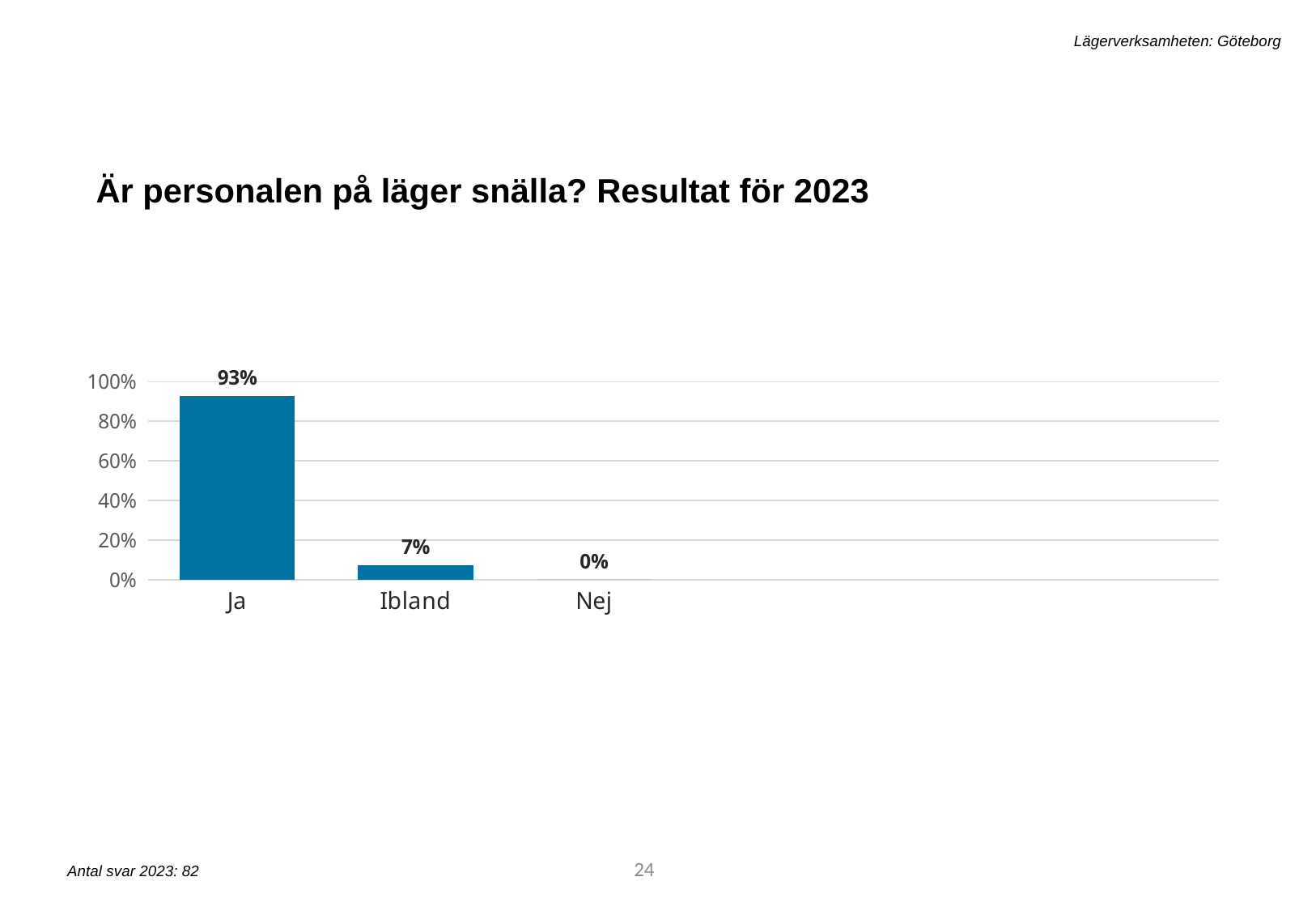
Is the value for Ja greater or less than 80%? greater Is the value for Ibland greater or less than 20%? less Which category has the lowest value? Nej Which is larger, the value for Ibland or the value for Nej? Ibland What is the title of the slide? Är personalen på läger snälla? Resultat för 2023 What is the value for Ja? 93% What kind of chart is shown on the slide? bar chart Which category has the highest value? Ja What is the value for Ibland? 7% What is the difference between the values for Ja and Ibland? 86% How many categories are shown on the x axis? 3 What is the value for Nej? 0%